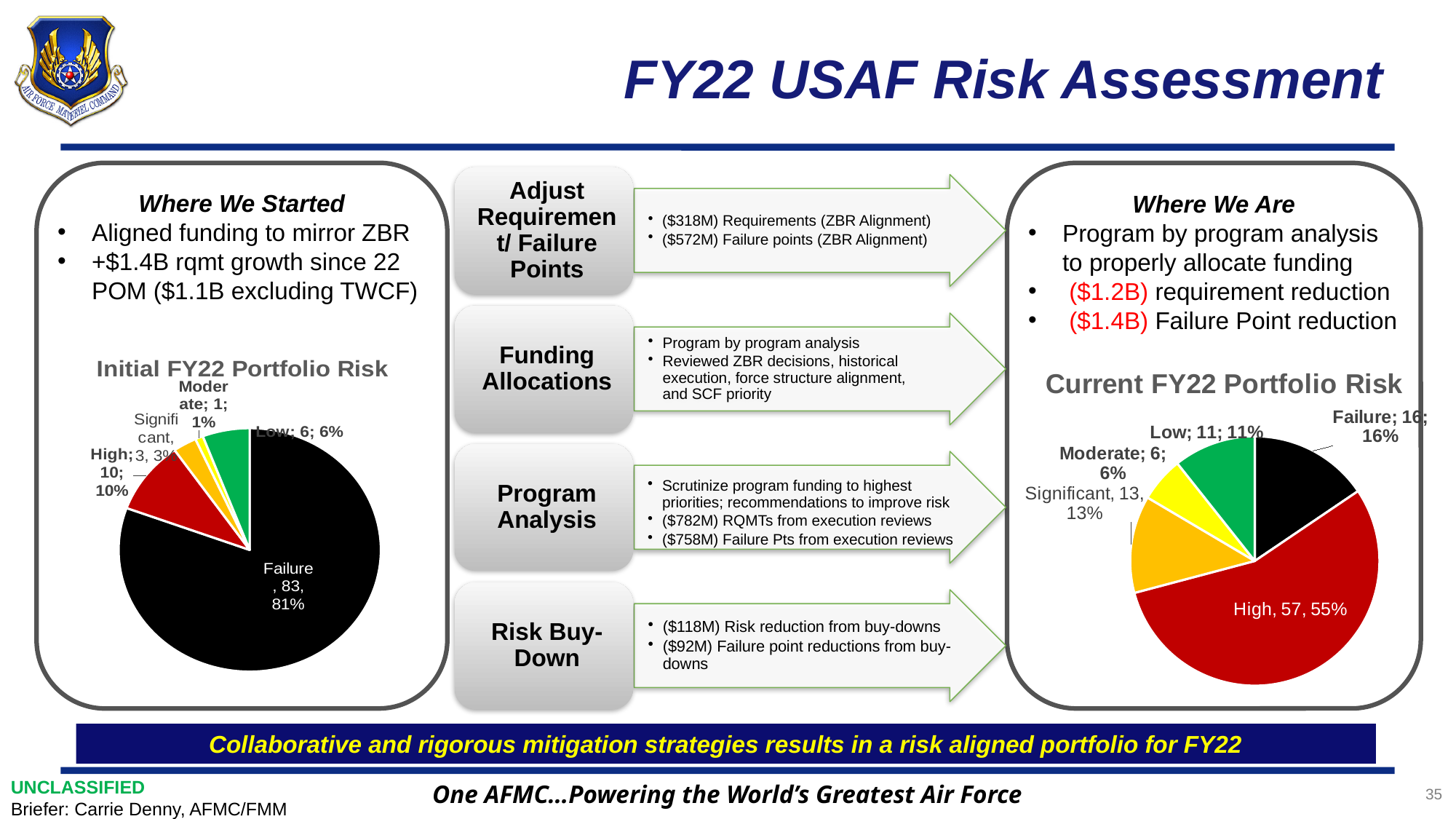
In the Initial FY22 Portfolio Risk chart, which category is the smallest? Moderate In the Current FY22 Portfolio Risk chart, which is larger, Significant or Low? Significant What type of chart is the Current FY22 Portfolio Risk chart? Pie chart In the Initial FY22 Portfolio Risk chart, what share of the pie does High represent? 10% In the Initial FY22 Portfolio Risk chart, how many categories are shown? 5 In the Initial FY22 Portfolio Risk chart, which category is the largest? Failure In the Current FY22 Portfolio Risk chart, what is the value for High? 57 In the Current FY22 Portfolio Risk chart, what share of the pie does Failure represent? 16% In the Current FY22 Portfolio Risk chart, what is the difference between the values for High and Failure? 41 In the Initial FY22 Portfolio Risk chart, what is the value for Failure? 83 In the Current FY22 Portfolio Risk chart, which category is the largest? High In the Current FY22 Portfolio Risk chart, which category is the smallest? Moderate